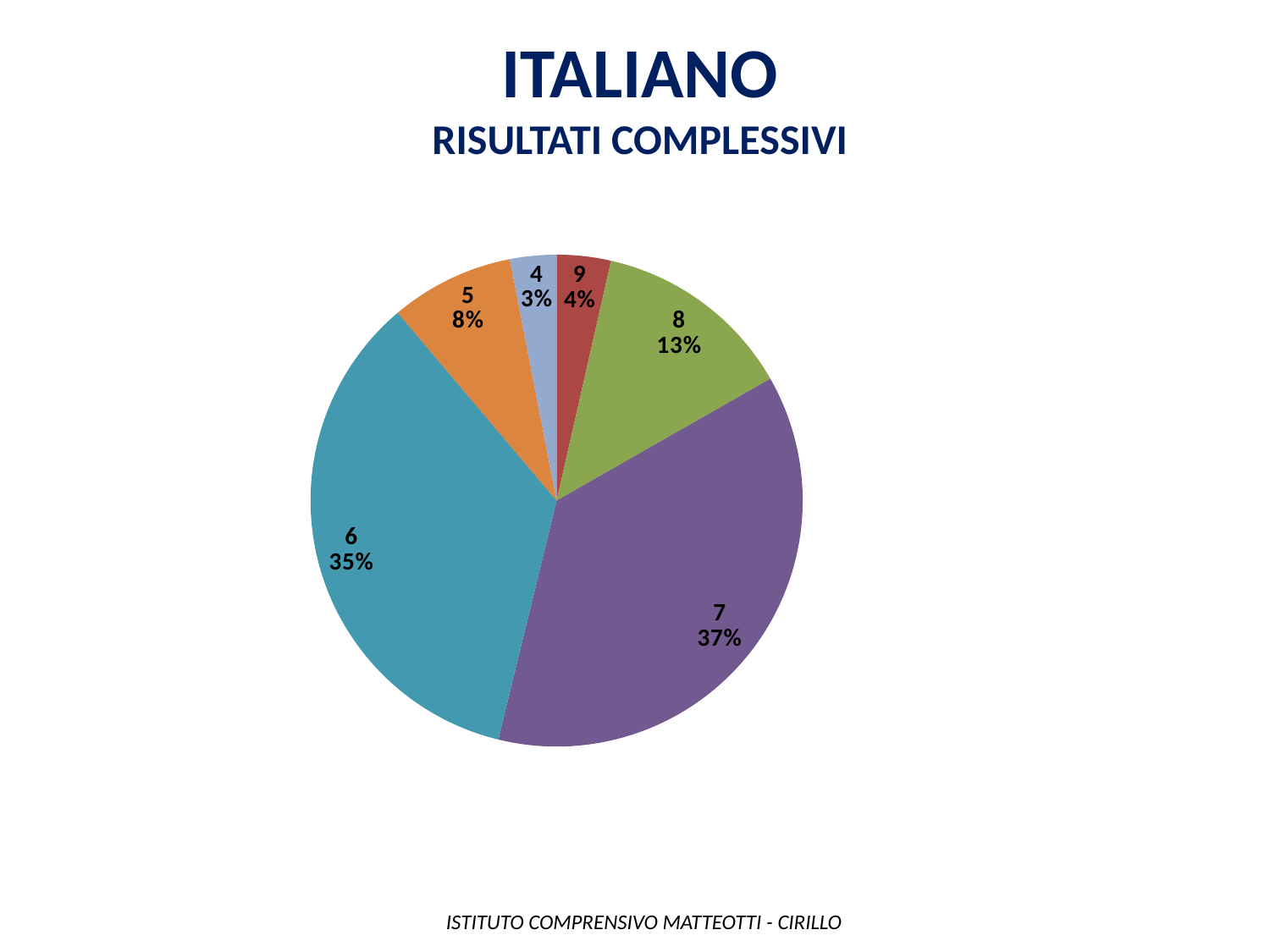
Which slice has a larger share, the one labelled 9 or the one labelled 4? 9 What percentage share does the slice labelled 8 have? 13% What percentage share does the slice labelled 7 have? 37% Which slice has the smallest share of the pie? 4 What kind of chart is shown on the slide? pie chart What percentage share does the slice labelled 5 have? 8% What is the difference in percentage points between the slice labelled 8 and the slice labelled 5? 5 How many slices does the pie chart have? 6 Which slice has the largest share of the pie? 7 What percentage share does the slice labelled 6 have? 35% What percentage share does the slice labelled 9 have? 4% What percentage share does the slice labelled 4 have? 3%